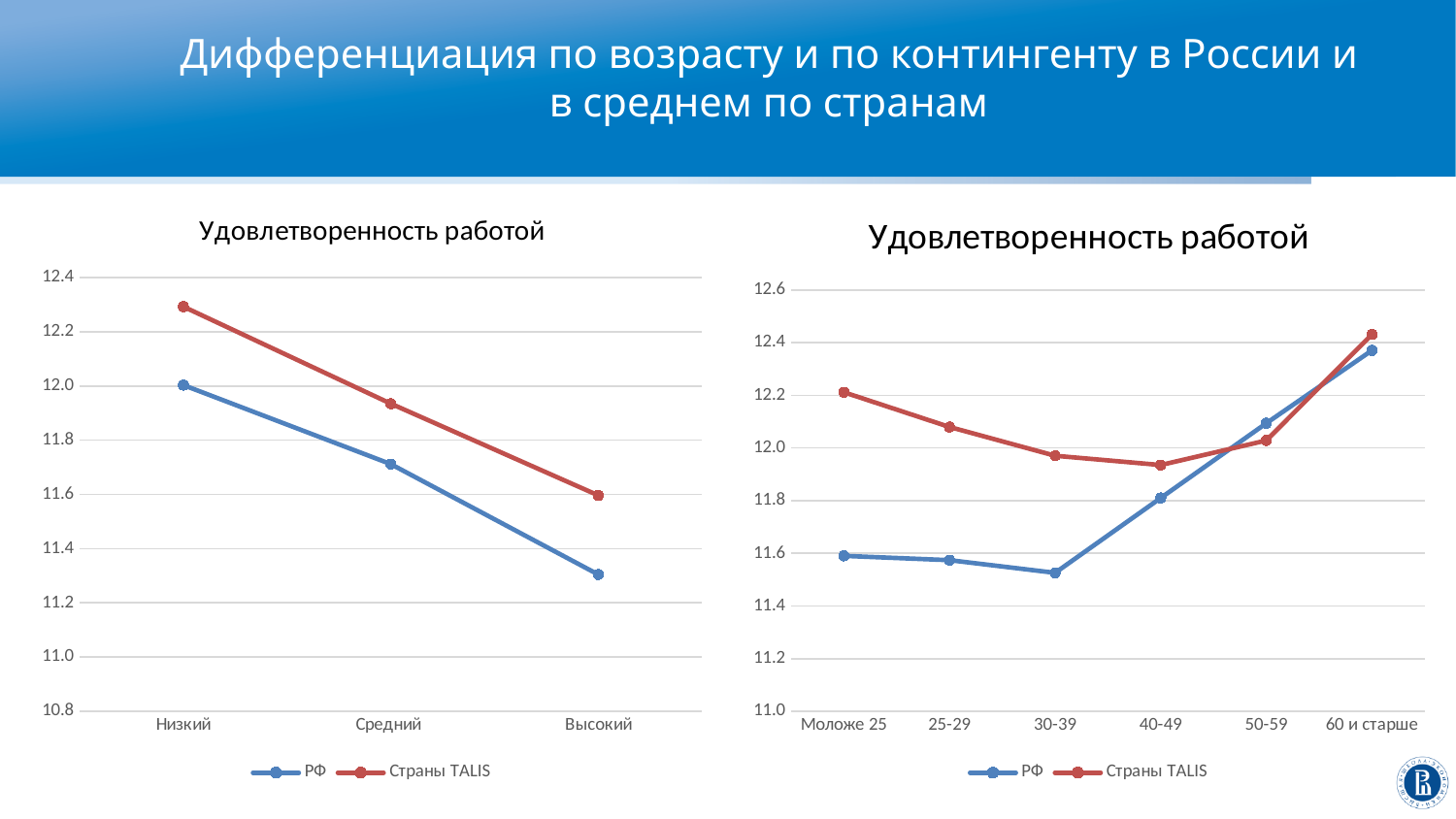
In the left chart, do the values for РФ rise or fall from Низкий to Высокий? fall In the right chart, which series is higher at 50-59, РФ or Страны TALIS? РФ What kind of chart is the left chart on the slide? line chart In the right chart, which age group has the lowest value for РФ? 30-39 How many categories are shown on the x axis of the left chart? 3 In the left chart, is the value for РФ at Высокий greater or less than 11.4? less How many age categories are shown on the x axis of the right chart? 6 How many series does the legend of the right chart list? 2 In the left chart, is the value for Страны TALIS at Высокий greater or less than 11.4? greater What is the title of the right chart? Удовлетворенность работой In the left chart, which series is higher at Средний, РФ or Страны TALIS? Страны TALIS In the right chart, which age group has the highest value for Страны TALIS? 60 и старше